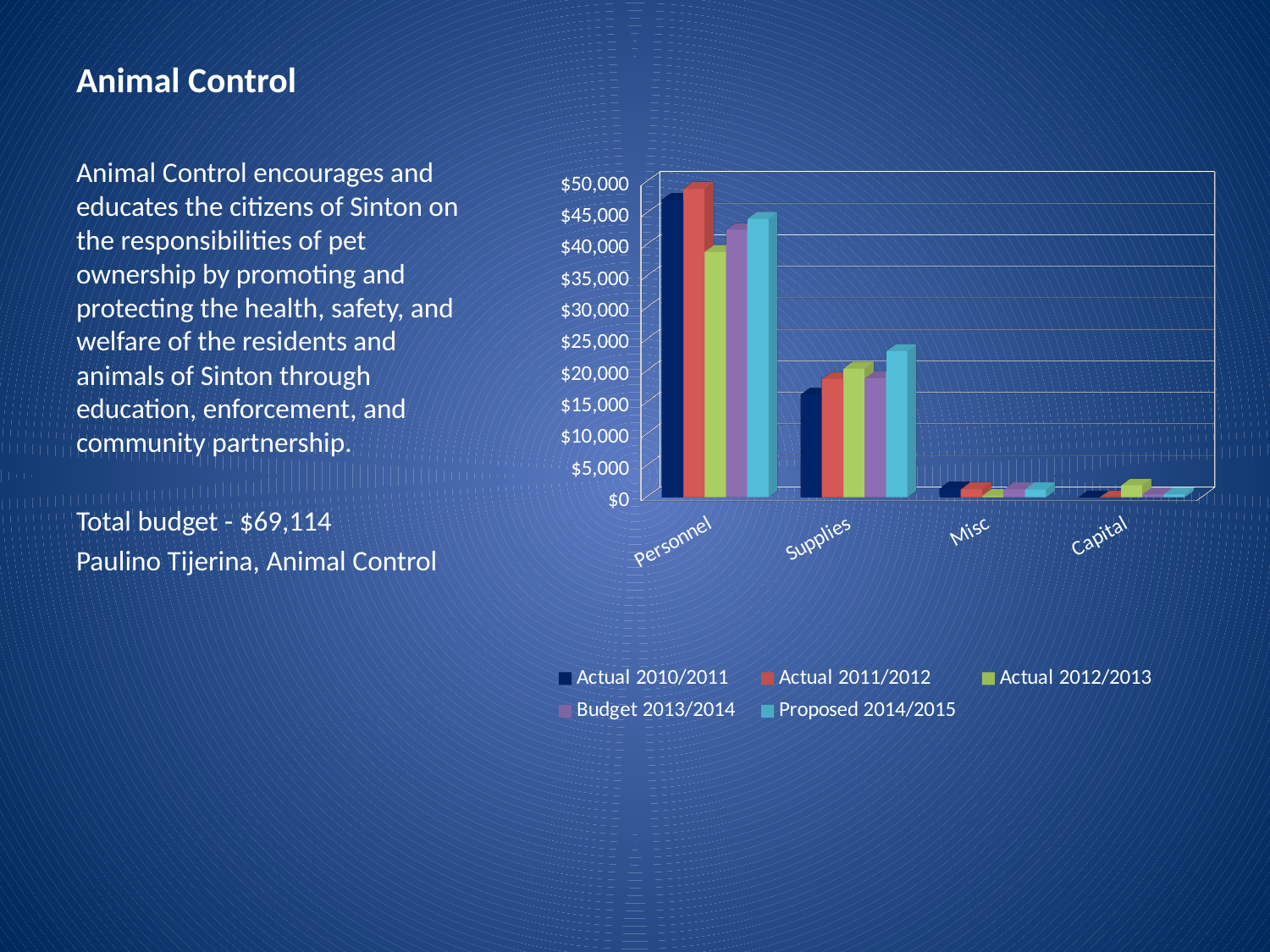
Is the Proposed 2014/2015 value for Supplies greater or less than $20,000? greater Is the Actual 2010/2011 value for Supplies greater or less than $20,000? less Which series is shown in light blue in the chart's legend? Proposed 2014/2015 For the Actual 2010/2011 series, which is larger: Personnel or Supplies? Personnel Is the Actual 2012/2013 value for Personnel greater or less than $45,000? less What kind of chart is shown on the slide? Bar chart Within the Supplies category, which series has the tallest bar? Proposed 2014/2015 Which category has the highest values in the chart? Personnel Within the Personnel category, which series has the tallest bar? Actual 2011/2012 How many series does the chart's legend list? 5 How many categories are shown on the x axis of the chart? 4